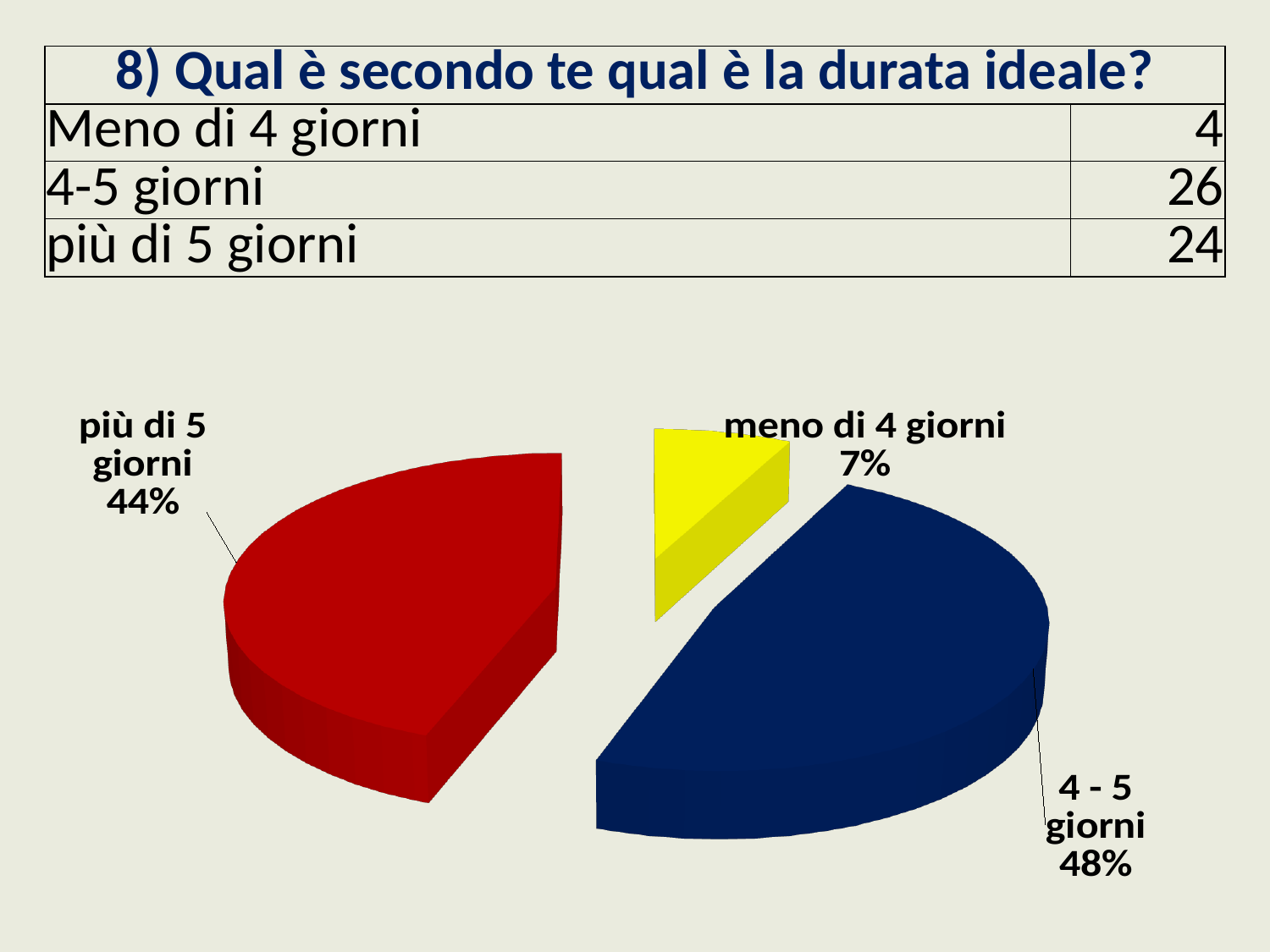
Which category has the largest slice of the pie? 4 - 5 giorni What is the difference in percentage points between the '4 - 5 giorni' slice and the 'più di 5 giorni' slice? 4 percentage points What share of the pie does the '4 - 5 giorni' slice represent? 48% What colour is the 'meno di 4 giorni' slice? yellow Which category has the smallest slice of the pie? meno di 4 giorni What kind of chart is shown on the slide? pie chart What share of the pie does the 'meno di 4 giorni' slice represent? 7% What share of the pie does the 'più di 5 giorni' slice represent? 44% Which slice is larger, 'più di 5 giorni' or 'meno di 4 giorni'? più di 5 giorni What colour is the '4 - 5 giorni' slice? dark blue How many slices does the pie chart have? 3